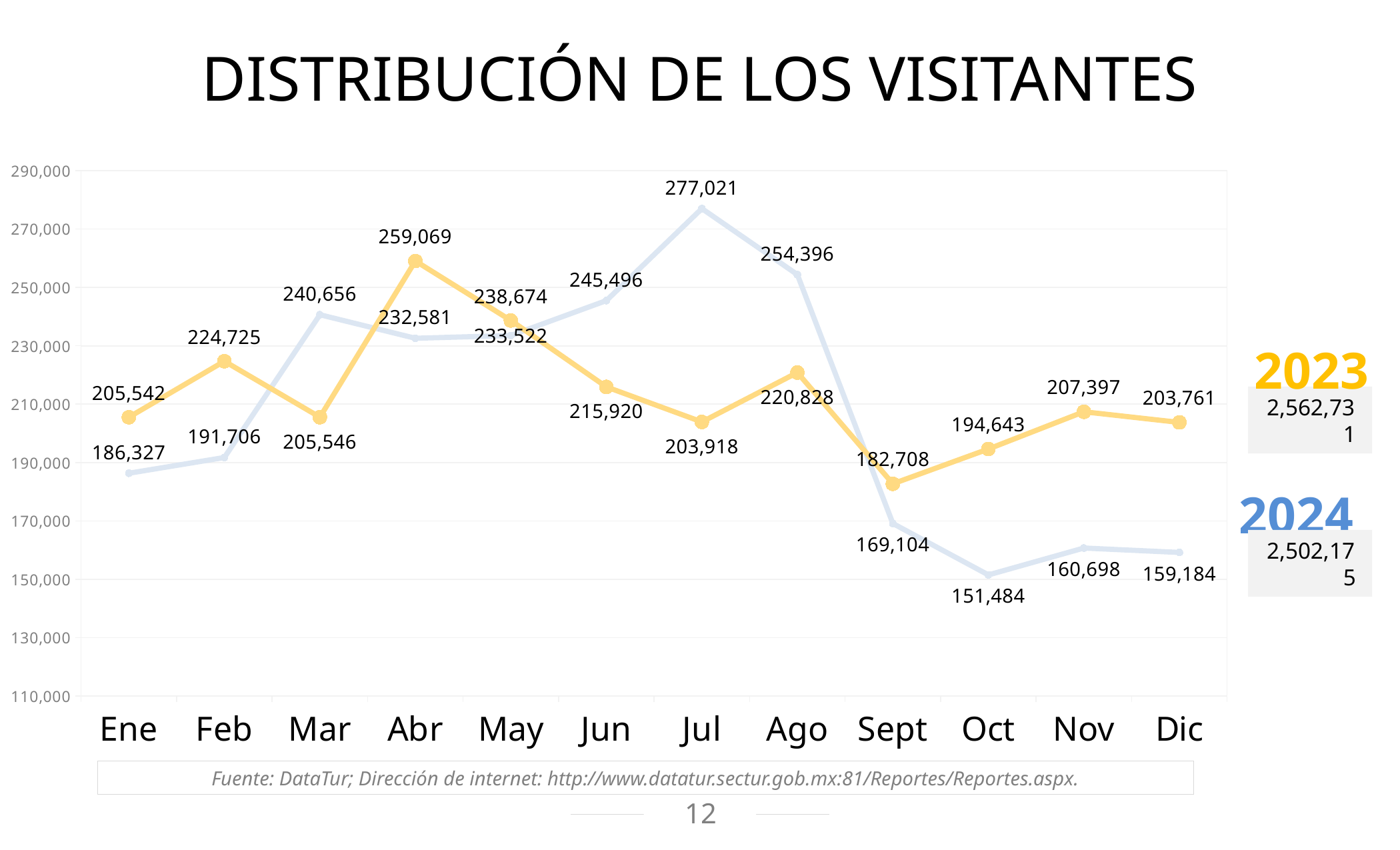
How many series does the chart show? 2 How many months are plotted along the x axis? 12 What annual total is shown for 2023 next to the chart? 2,562,731 Do the 2024 values rise or fall from Ago to Oct? fall What is the value for Oct in the 2024 series? 151,484 What is the difference between the 2024 and 2023 values for Jul? 73,103 Is the value for Jul in the 2024 series greater or less than 270,000? greater Which month has the lowest value in the 2023 series? Sept What is the value for Abr in the 2023 series? 259,069 Which series has the larger value in Mar, 2023 or 2024? 2024 Which month has the highest value in the 2024 series? Jul What type of chart is shown on the slide? line chart